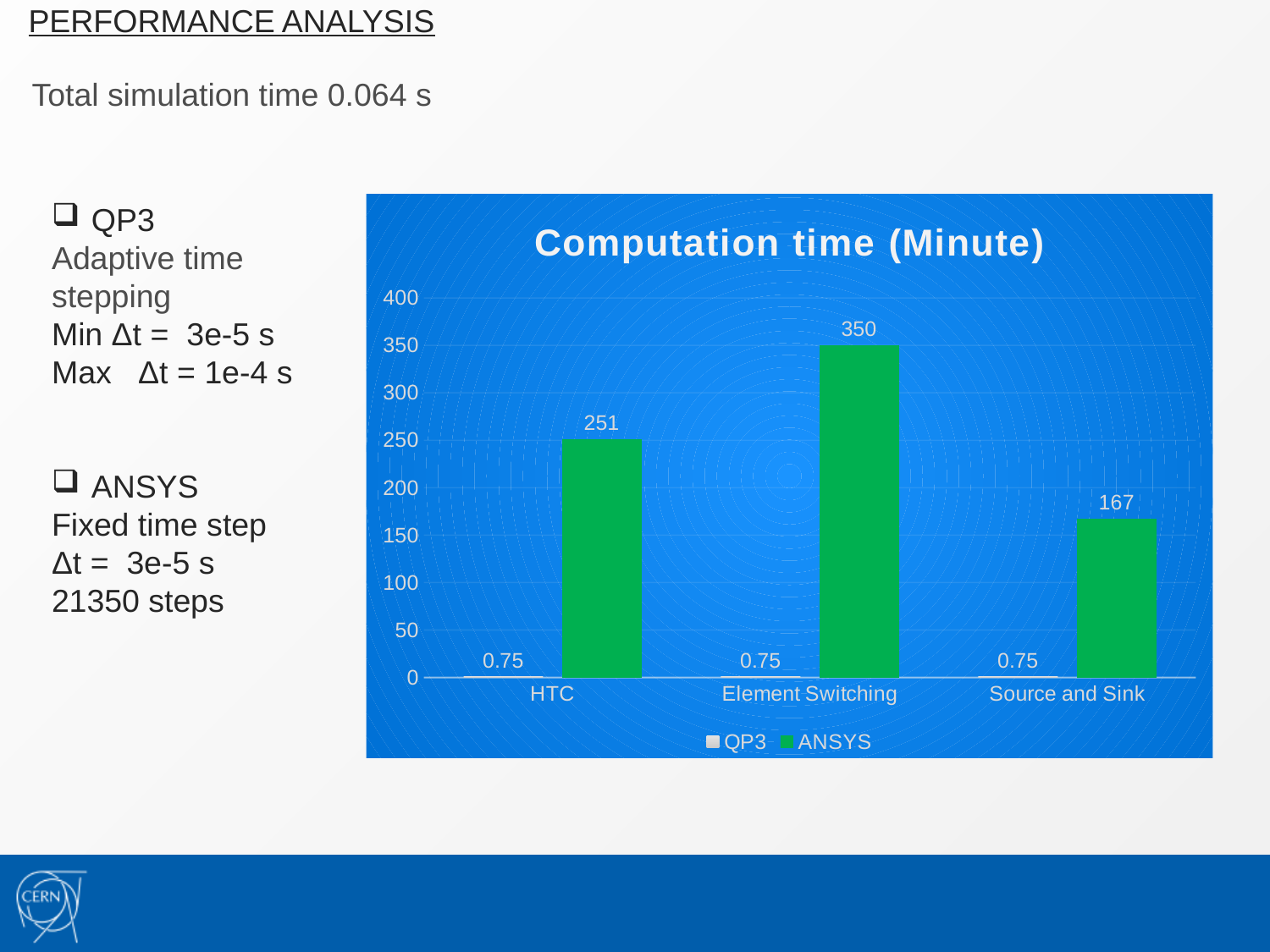
What is the ANSYS computation time for HTC? 251 What is the QP3 computation time for Source and Sink? 0.75 Which category has the highest ANSYS computation time? Element Switching What is the title of the chart? Computation time (Minute) How many series does the legend list? 2 Which is larger, the ANSYS computation time for HTC or for Source and Sink? HTC What kind of chart is shown? bar chart How many categories are shown on the x axis? 3 What is the difference between the ANSYS computation times for Element Switching and HTC? 99 Which category has the lowest ANSYS computation time? Source and Sink What is the ANSYS computation time for Element Switching? 350 What is the difference between the ANSYS and QP3 computation times for Source and Sink? 166.25